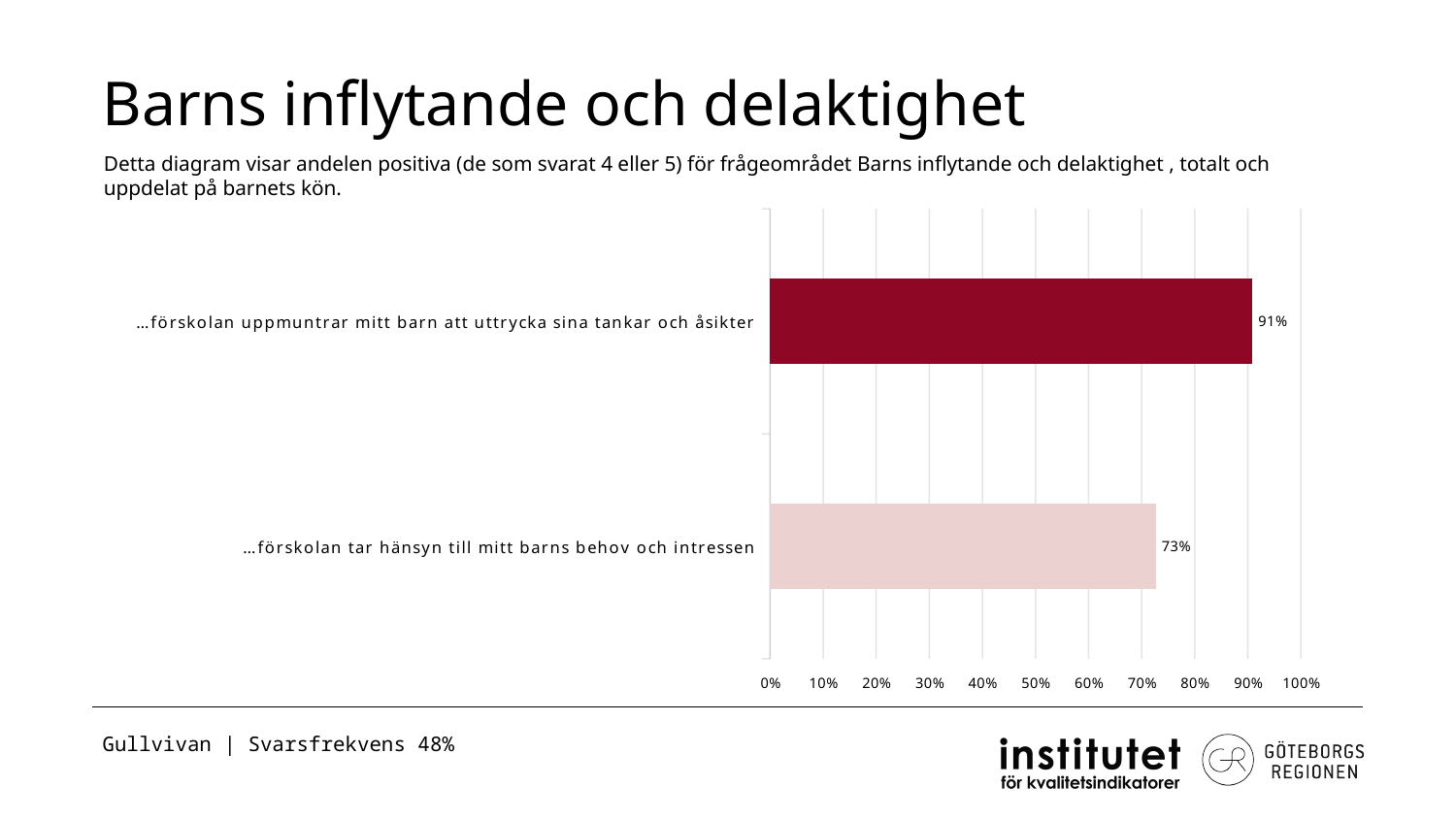
What is the value for "…förskolan uppmuntrar mitt barn att uttrycka sina tankar och åsikter"? 91% How many categories are shown in the chart? 2 What kind of chart is shown on the slide? bar chart Which is larger: the value for "…förskolan uppmuntrar mitt barn att uttrycka sina tankar och åsikter" or for "…förskolan tar hänsyn till mitt barns behov och intressen"? …förskolan uppmuntrar mitt barn att uttrycka sina tankar och åsikter Is the value for "…förskolan tar hänsyn till mitt barns behov och intressen" greater or less than 80%? less What is the title of the slide containing the chart? Barns inflytande och delaktighet What is the value for "…förskolan tar hänsyn till mitt barns behov och intressen"? 73% Which category has the lowest value? …förskolan tar hänsyn till mitt barns behov och intressen What is the maximum value shown on the x axis? 100% What is the difference between the values for "…förskolan uppmuntrar mitt barn att uttrycka sina tankar och åsikter" and "…förskolan tar hänsyn till mitt barns behov och intressen"? 18% Which category has the highest value? …förskolan uppmuntrar mitt barn att uttrycka sina tankar och åsikter Is the value for "…förskolan uppmuntrar mitt barn att uttrycka sina tankar och åsikter" greater or less than 90%? greater